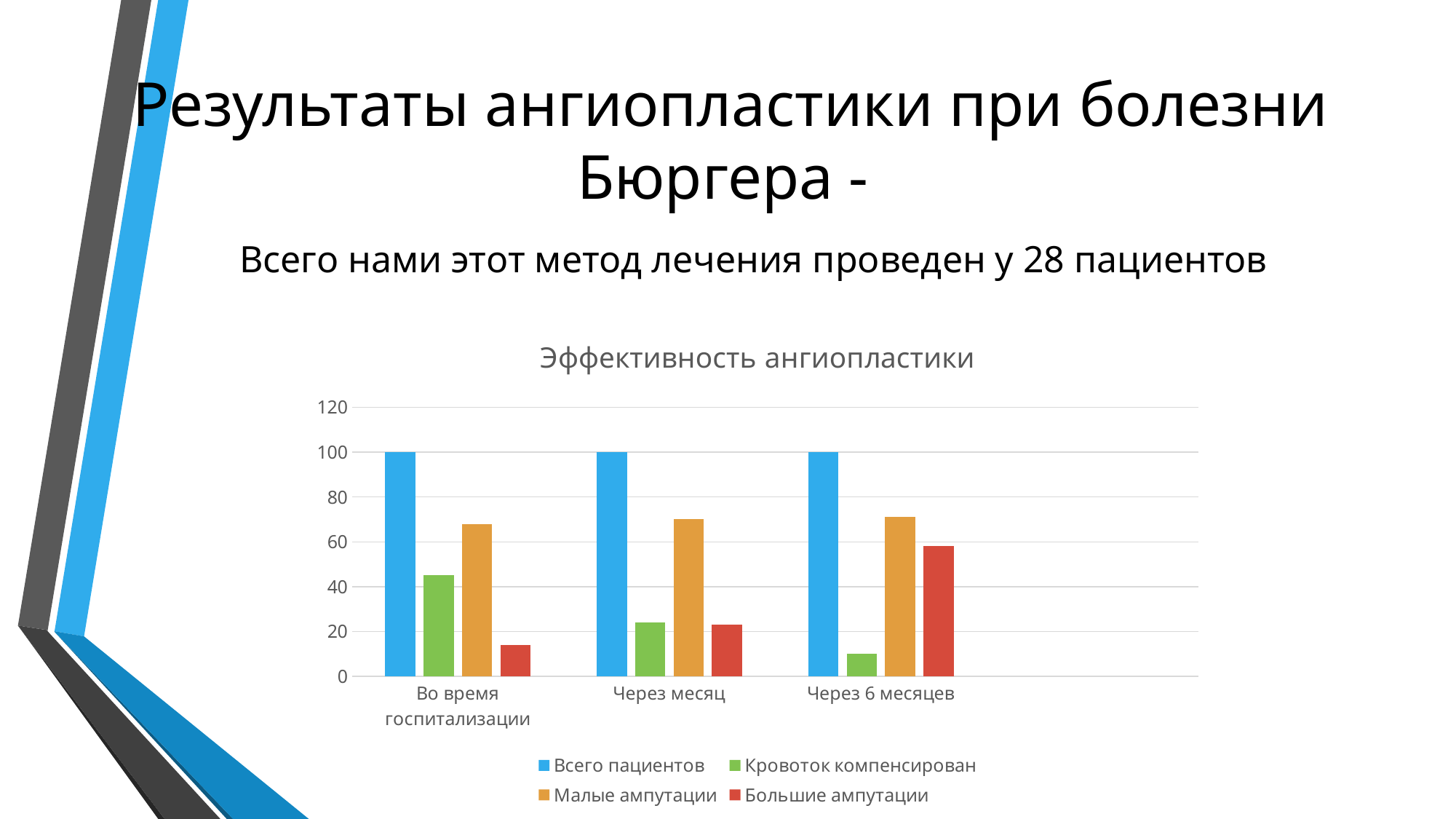
What is the value for Всего пациентов in the category Во время госпитализации? 100 What type of chart is shown on the slide? bar chart What is the title of the chart? Эффективность ангиопластики How many categories are shown on the x axis of the chart? 3 In which category is the value for Кровоток компенсирован the highest? Во время госпитализации Does the value for Большие ампутации rise or fall across the categories from Во время госпитализации to Через 6 месяцев? rise Is the value for Кровоток компенсирован in the category Через 6 месяцев greater or less than 20? less How many series does the chart legend list? 4 Is the value for Кровоток компенсирован in the category Во время госпитализации greater or less than 40? greater Is the value for Большие ампутации in the category Во время госпитализации greater or less than 20? less What is the value for Всего пациентов in the category Через месяц? 100